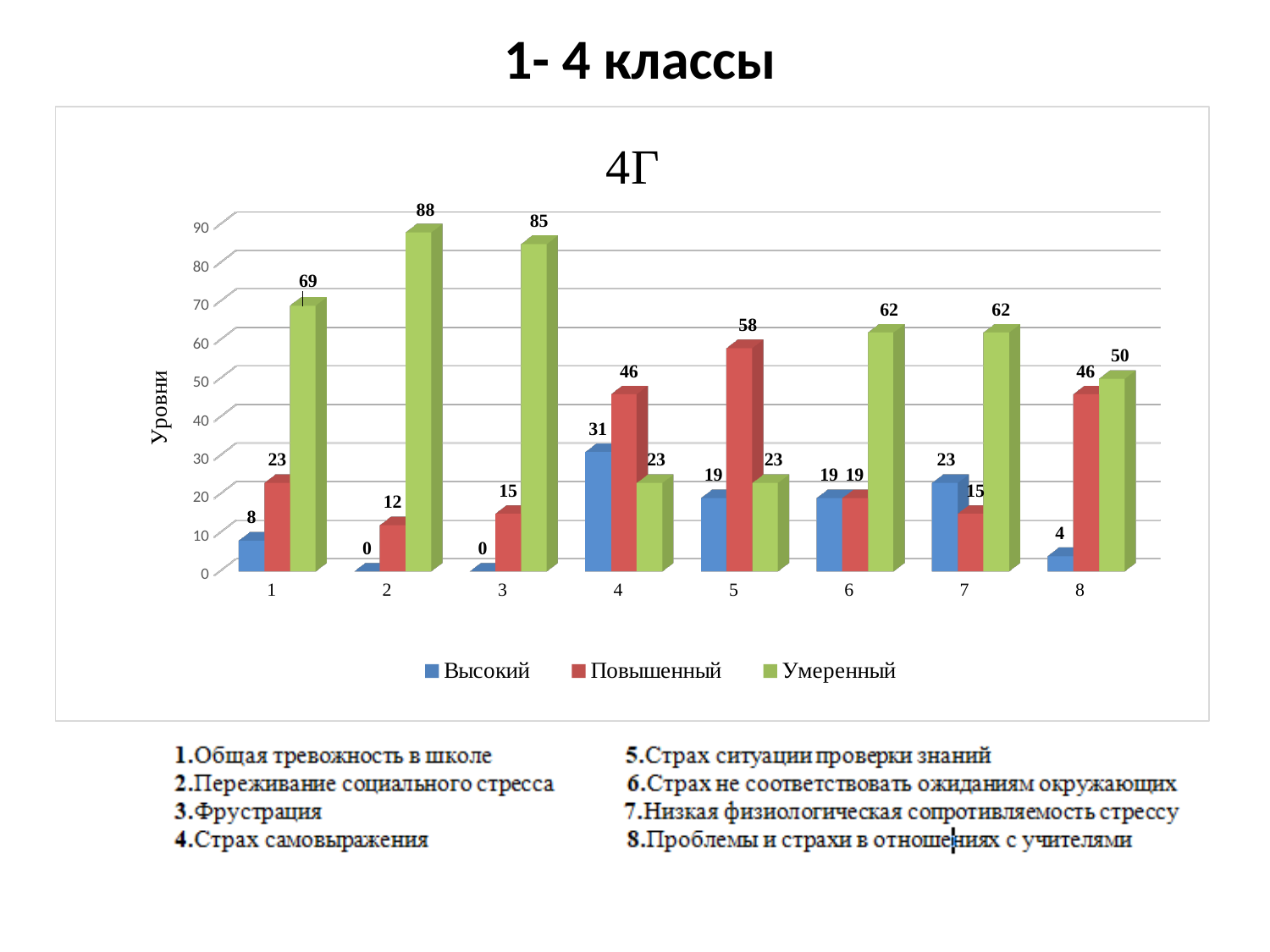
What is the value of the Повышенный series for category 5? 58 What is the label on the vertical axis? Уровни Which category has the lowest value in the Повышенный series? 2 Which category has the highest value in the Умеренный series? 2 What is the difference between the Умеренный and Высокий values for category 1? 61 What is the title of the chart? 4Г What kind of chart is shown? bar chart How many series does the legend list? 3 What is the value of the Умеренный series for category 2? 88 For category 8, which is larger: the Повышенный value or the Умеренный value? Умеренный How many categories are shown on the x axis? 8 What is the value of the Высокий series for category 4? 31